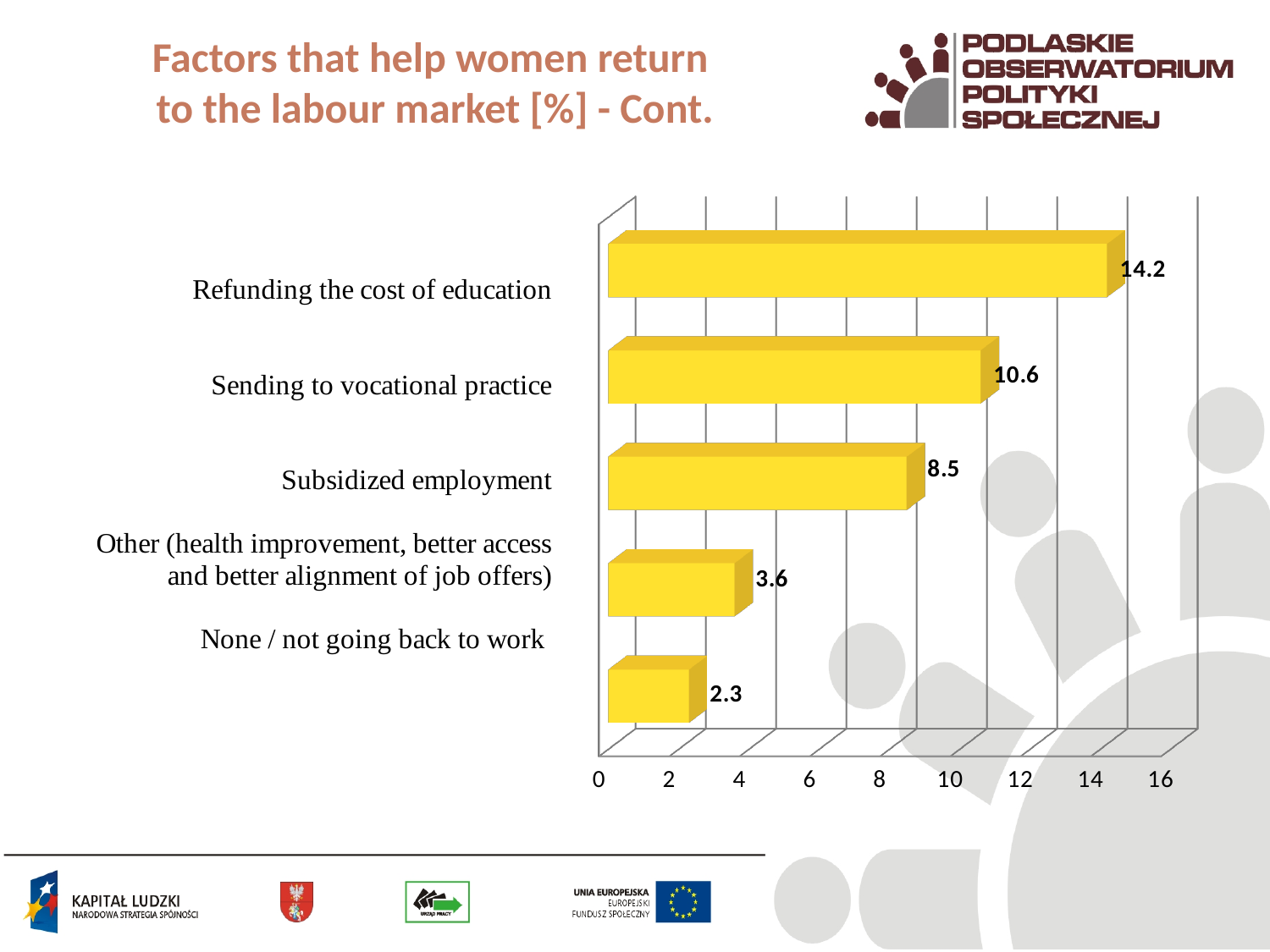
What is the difference between Refunding the cost of education and Sending to vocational practice? 3.6 What is the title of the slide? Factors that help women return to the labour market [%] - Cont. Which factor has the highest value? Refunding the cost of education What is the value for None / not going back to work? 2.3 What is the value for Subsidized employment? 8.5 What kind of chart is shown on the slide? Bar chart What is the value for Sending to vocational practice? 10.6 What is the value for Refunding the cost of education? 14.2 Which is larger, Subsidized employment or the Other category? Subsidized employment How many categories are shown in the chart? 5 What is the difference between Subsidized employment and None / not going back to work? 6.2 Which category has the lowest value? None / not going back to work